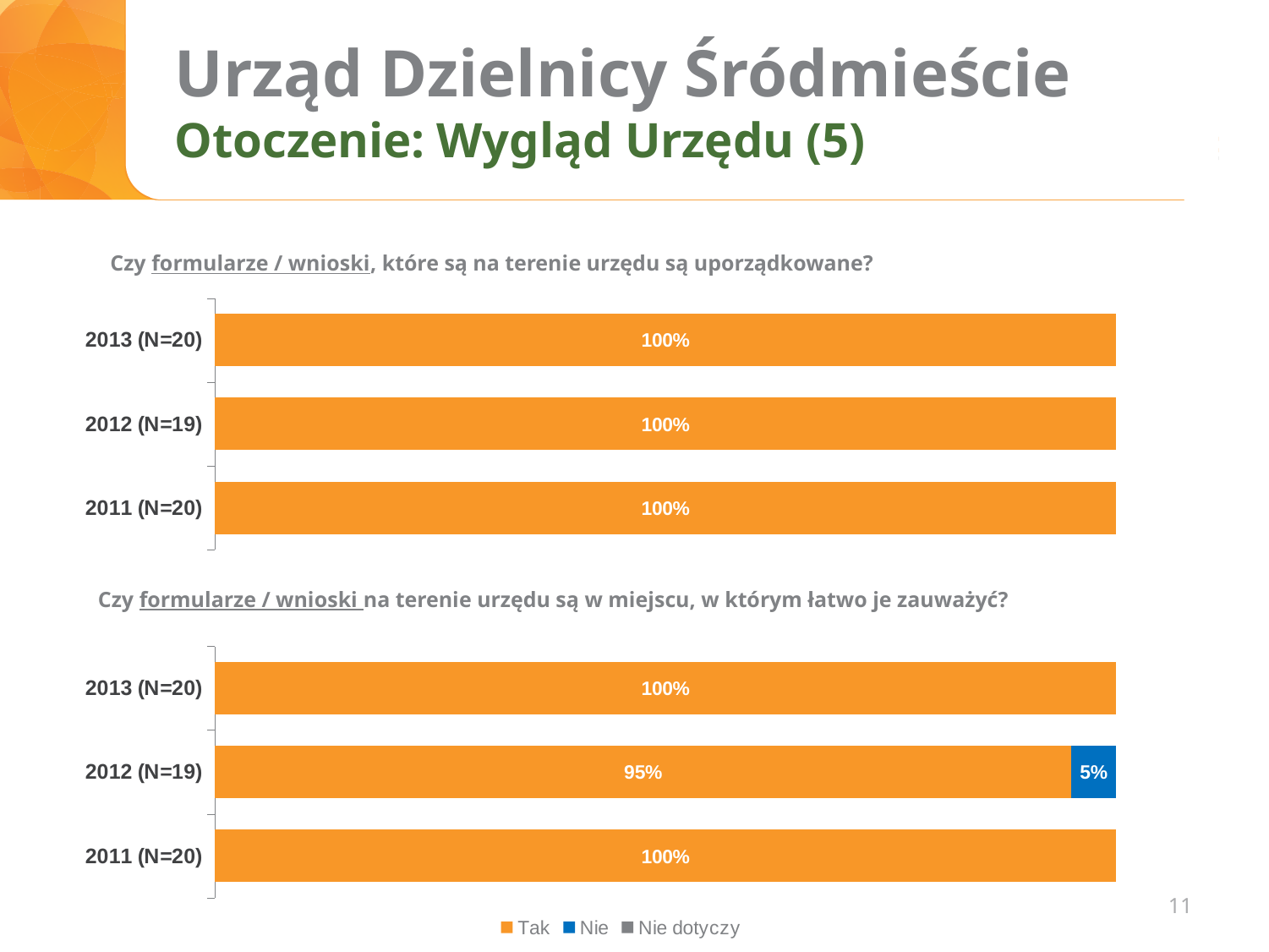
How many series does the legend at the bottom of the slide list? 3 In the bottom chart, what is the value for "Tak" in 2011 (N=20)? 100% In the bottom chart, which is larger: the "Tak" value for 2012 (N=19) or the "Nie" value for 2012 (N=19)? Tak In the bottom chart, what is the total of the stacked bar for 2012 (N=19)? 100% What type of chart is the top chart? Bar chart In the top chart ("Czy formularze / wnioski, które są na terenie urzędu są uporządkowane?"), what is the value for "Tak" in 2013 (N=20)? 100% What colour represents "Tak" in the legend? Orange In the bottom chart ("Czy formularze / wnioski na terenie urzędu są w miejscu, w którym łatwo je zauważyć?"), what is the value for "Tak" in 2012 (N=19)? 95% How many year categories does the top chart show? 3 In the bottom chart, what is the difference between the "Tak" value for 2013 (N=20) and the "Tak" value for 2012 (N=19)? 5% In the bottom chart, which year has the lowest "Tak" value? 2012 (N=19) In the bottom chart, what is the value for "Nie" in 2012 (N=19)? 5%